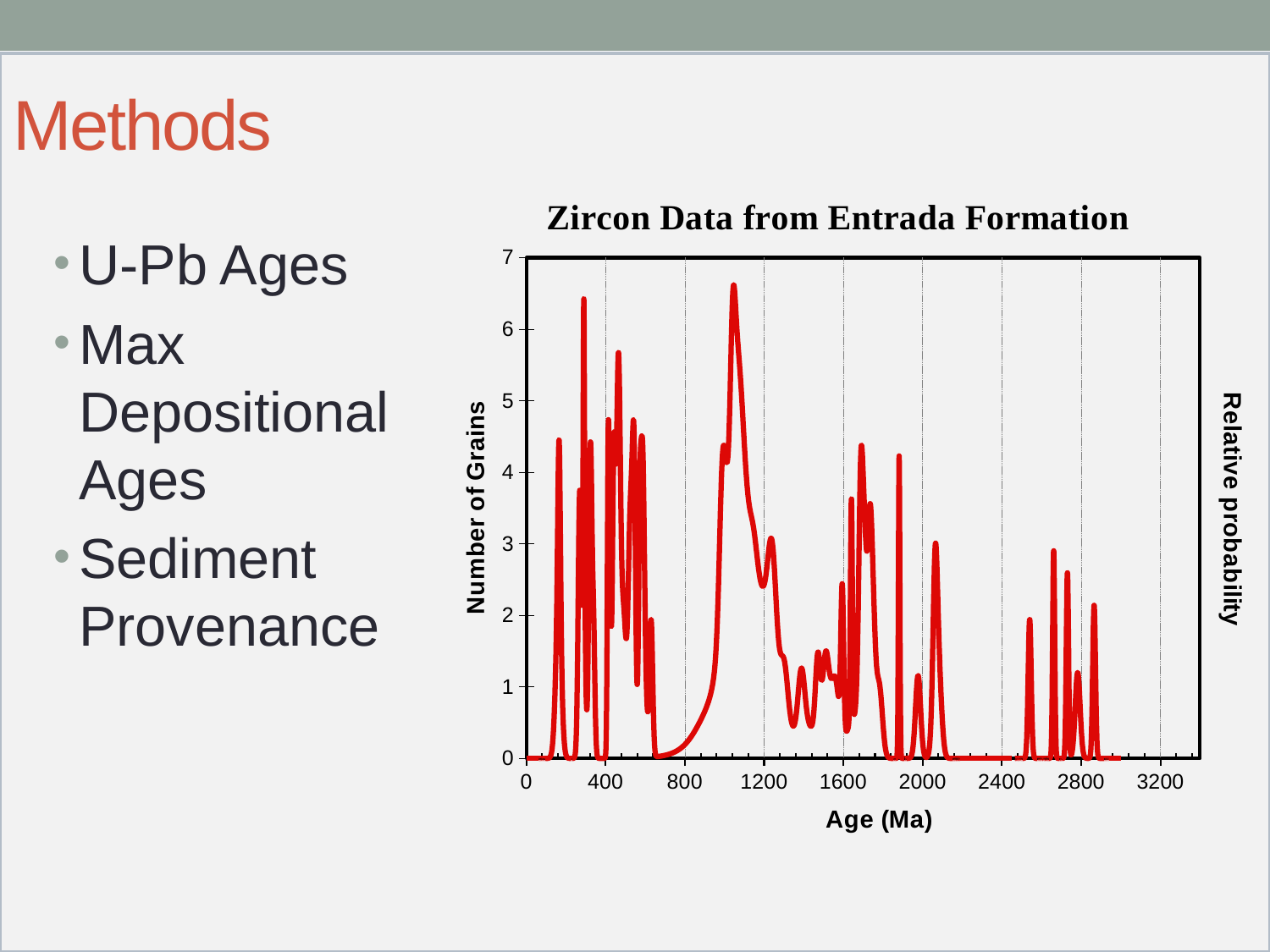
Is the peak near 1900 Ma greater or less than 3? greater What is the label of the x axis of the chart? Age (Ma) What is the highest value shown on the left y axis (Number of Grains)? 7 What is the highest value shown on the x axis (Age (Ma))? 3200 Is the peak near 2000 Ma greater or less than 2? less How many tick labels are shown on the x axis? 9 What is the title of the chart? Zircon Data from Entrada Formation Is the peak near 2550 Ma higher or lower than the peak near 2650 Ma? lower Is the peak near 1900 Ma higher or lower than the peak near 2000 Ma? higher Is the highest peak between 800 and 1200 Ma greater or less than 6? greater What kind of chart is shown on the slide? line chart